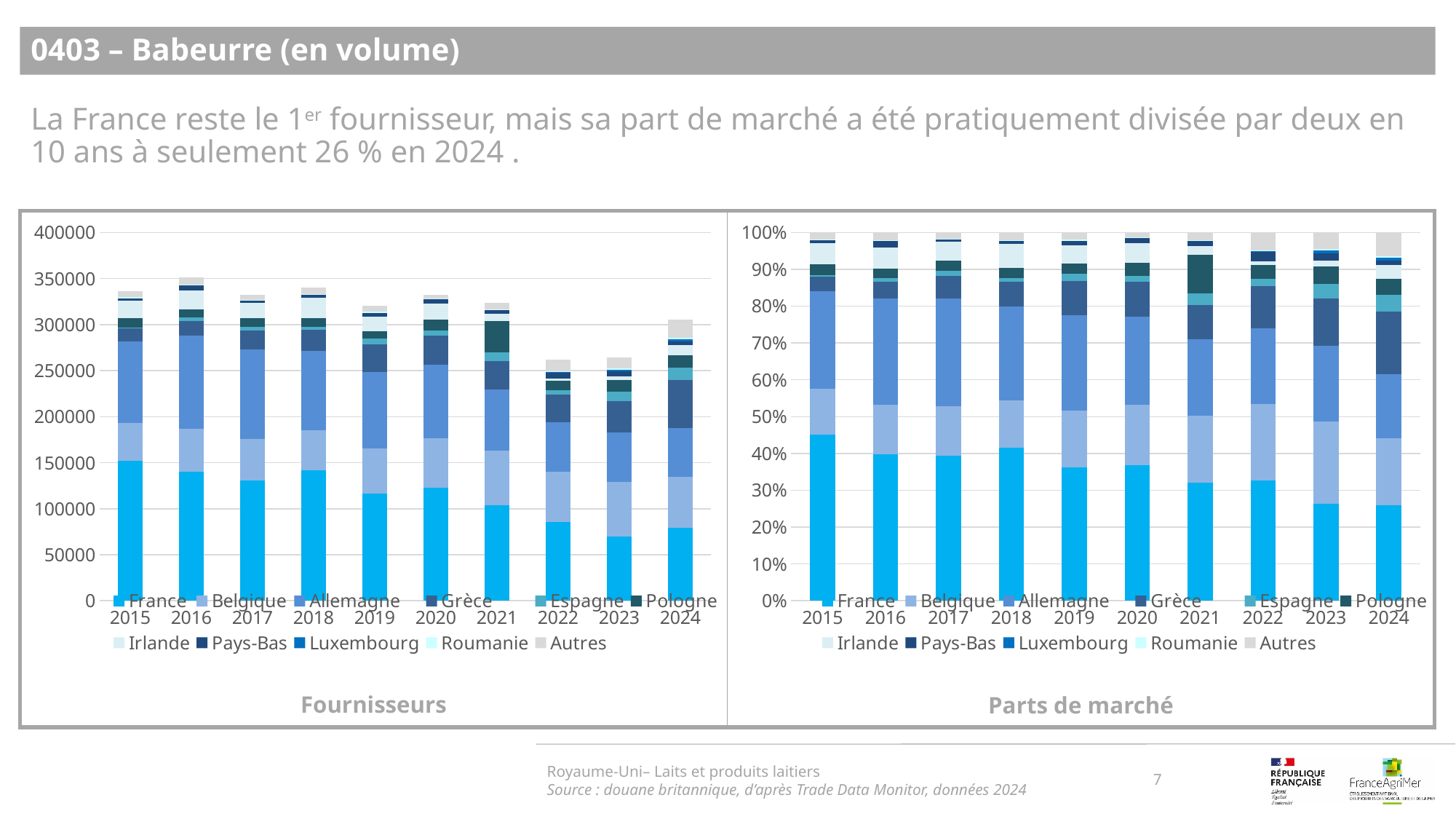
In the 'Fournisseurs' chart, which year has the largest France segment? 2015 What kind of chart is the 'Fournisseurs' chart on the left? Stacked bar chart In the 'Parts de marché' chart, does the France share rise or fall from 2015 to 2024? fall In the 'Parts de marché' chart, is the France share in 2015 greater or less than 40%? greater What is the title of the chart on the right of the slide? Parts de marché How many series does the legend of the 'Fournisseurs' chart list? 11 In the 'Fournisseurs' chart, is the France segment larger in 2015 or in 2024? 2015 How many years are shown on the x axis of the 'Parts de marché' chart? 10 In the 'Fournisseurs' chart, is the total bar for 2015 greater or less than 350000? less In the 'Fournisseurs' chart, is the France value for 2022 greater or less than 100000? less In the 'Fournisseurs' chart, which year has the highest total bar? 2016